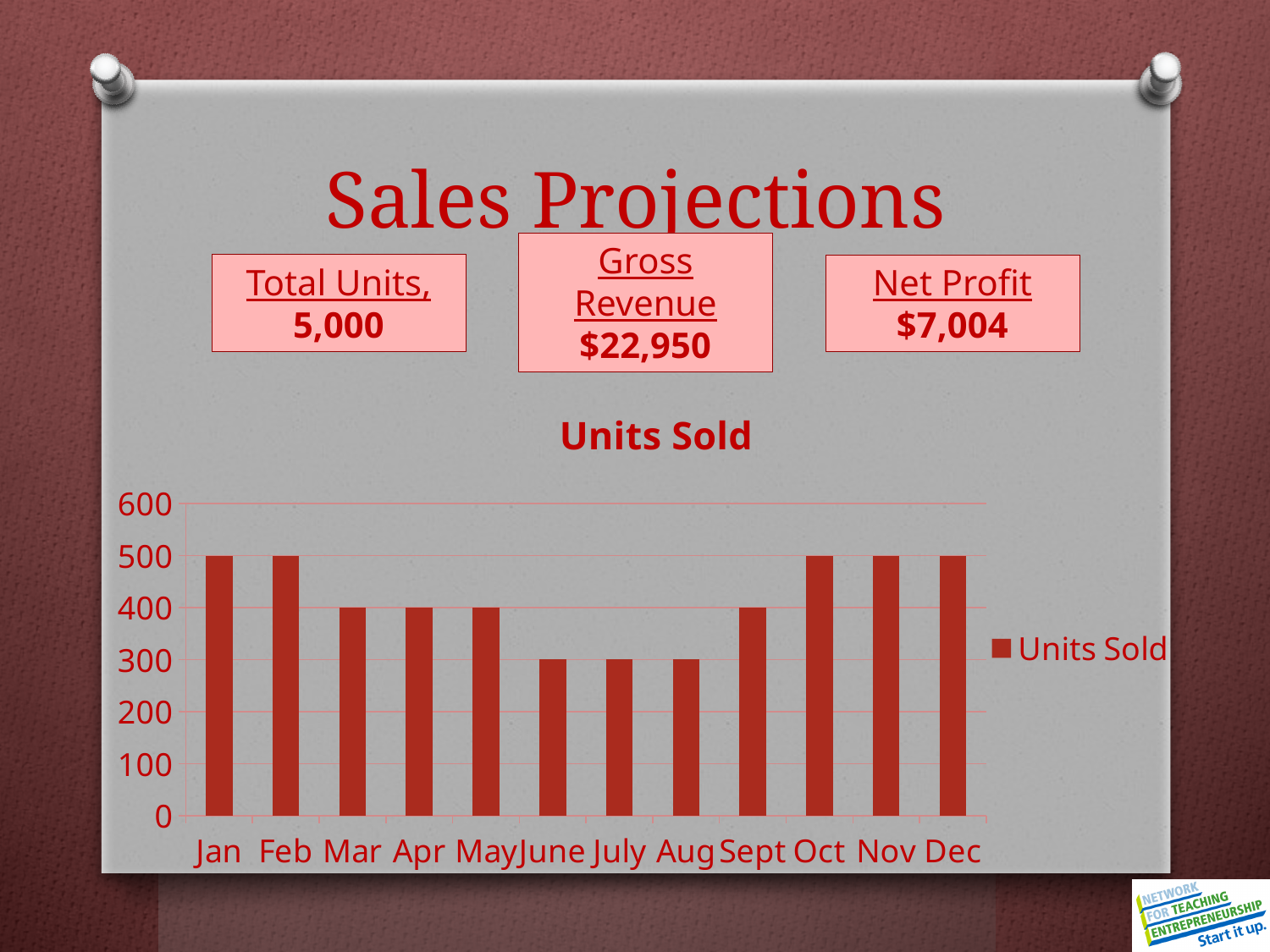
Which is larger in the Units Sold chart, the value for Mar or the value for Oct? Oct Is the value for Aug in the Units Sold chart greater or less than 400? less Which months have the lowest value in the Units Sold chart? June, July, Aug What type of chart is shown on the slide? bar chart What is the value for Jan in the Units Sold chart? 500 How many months are shown on the x axis of the Units Sold chart? 12 How many series does the legend of the Units Sold chart list? 1 What is the difference between the values for Feb and July in the Units Sold chart? 200 Do the values in the Units Sold chart rise or fall from Jan to June? fall What is the value for Sept in the Units Sold chart? 400 What is the title of the chart? Units Sold What is the value for June in the Units Sold chart? 300